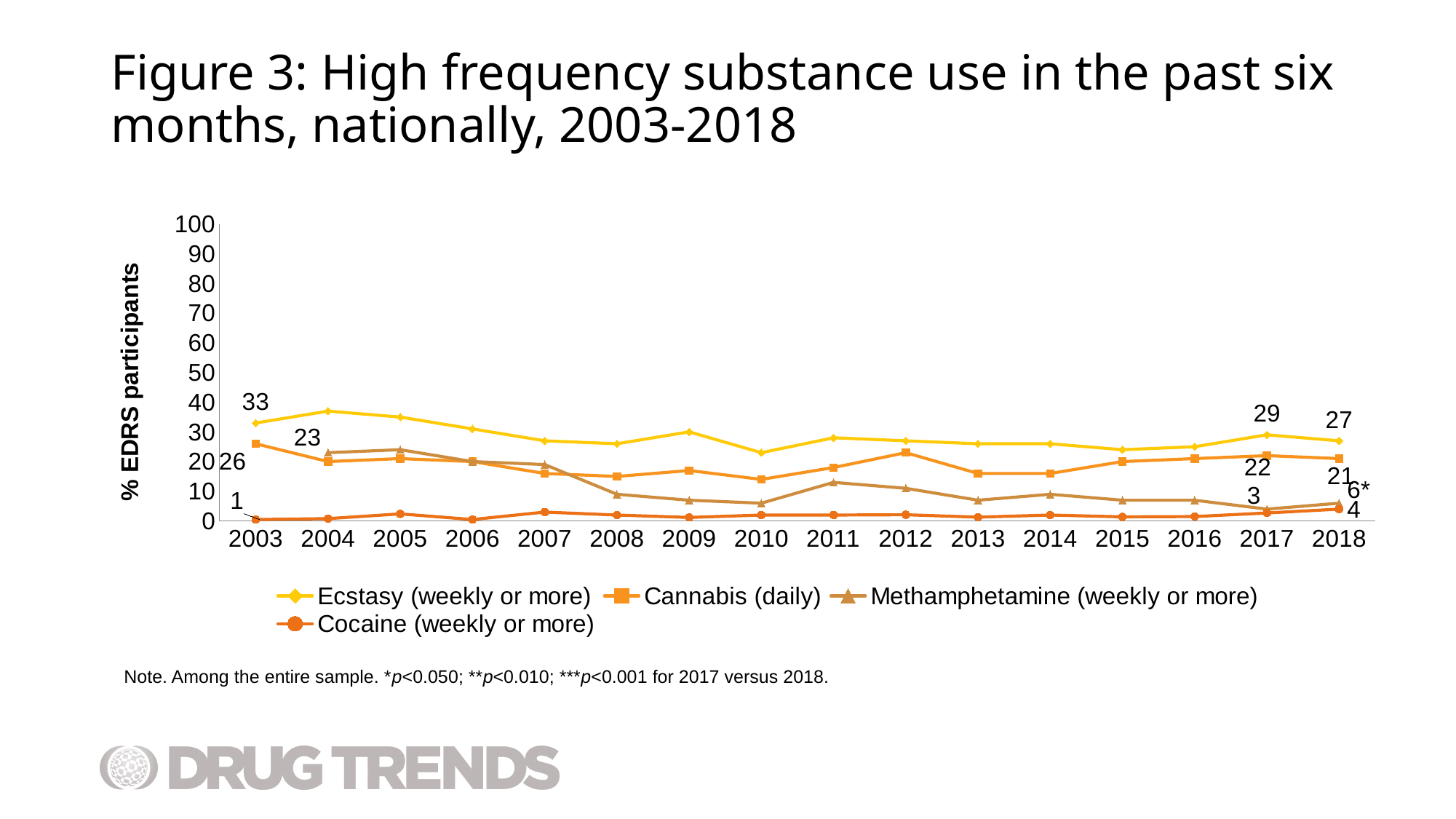
What is the label on the y axis? % EDRS participants What is the value for Cocaine (weekly or more) in 2018? 4 By how much did the Ecstasy (weekly or more) value fall from 2003 to 2018? 6 In 2018, which is larger: Ecstasy (weekly or more) or Cannabis (daily)? Ecstasy (weekly or more) How many series does the legend list? 4 What kind of chart is shown on the slide? Line chart What is the value for Ecstasy (weekly or more) in 2018? 27 How many years are plotted along the x axis? 16 What is the value for Cannabis (daily) in 2018? 21 Is the value for Ecstasy (weekly or more) in 2004 greater or less than 30? greater What is the value for Cocaine (weekly or more) in 2003? 1 What is the value for Ecstasy (weekly or more) in 2003? 33